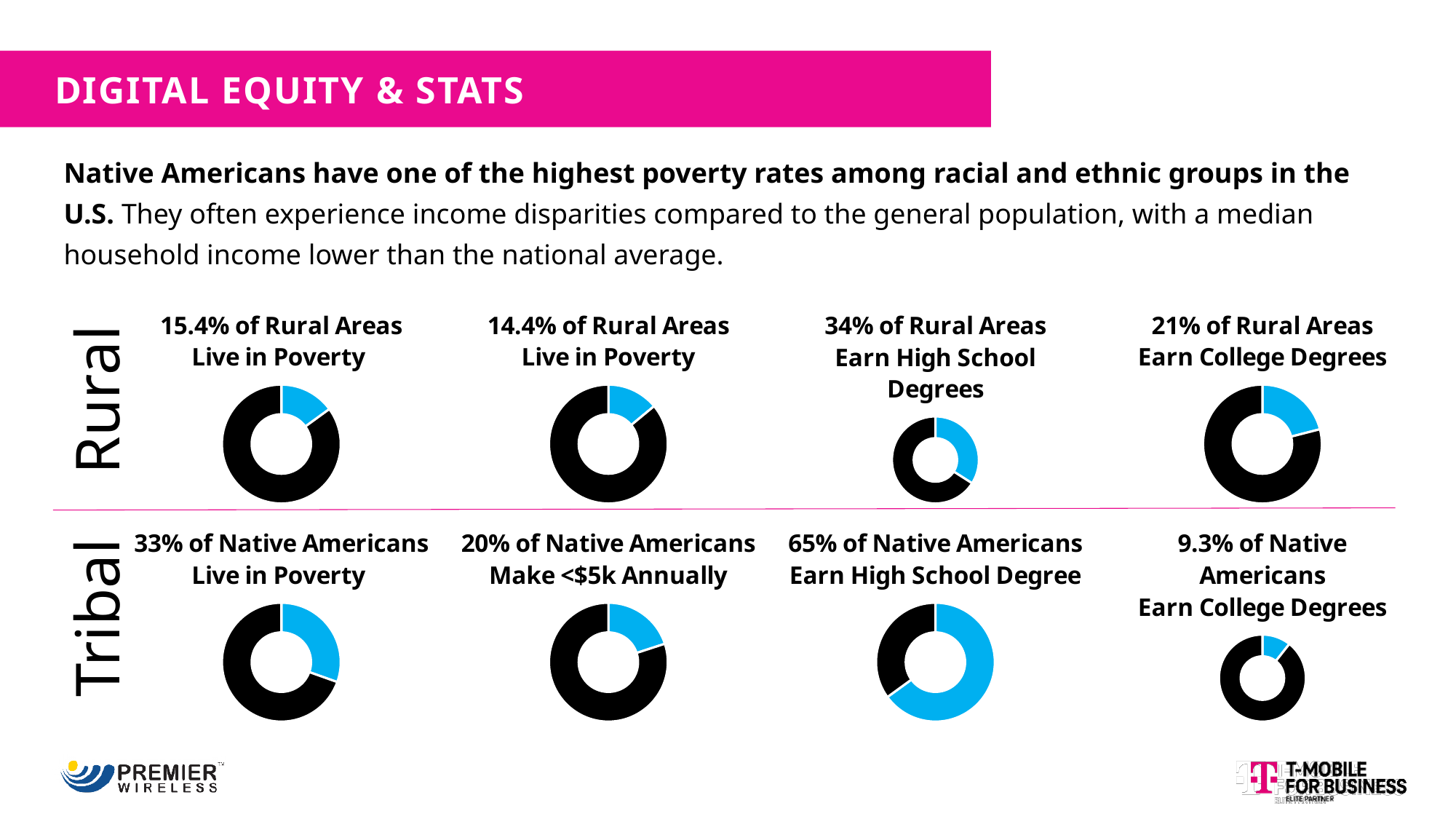
What colour is used for the highlighted slice in each donut chart? Blue Which is larger: the share of Native Americans living in poverty (Tribal row, first chart) or the share of rural areas living in poverty (Rural row, first chart)? Native Americans living in poverty (33%) Across all eight donut charts, which chart shows the smallest highlighted (blue) share? 9.3% of Native Americans Earn College Degrees In the Tribal row, what percentage of Native Americans make less than $5k annually according to the second chart? 20% What is the difference between the share of Native Americans earning a high school degree (Tribal row, third chart) and the share of rural areas earning high school degrees (Rural row, third chart)? 31% In the Rural row, what percentage of rural areas earn college degrees according to the fourth chart? 21% How many donut charts are on the slide? 8 What kind of charts are shown on the slide? Donut (pie) charts What is the difference between the share of rural areas earning college degrees (Rural row, fourth chart) and the share of Native Americans earning college degrees (Tribal row, fourth chart)? 11.7% In the Tribal row, what percentage of Native Americans earn college degrees according to the fourth chart? 9.3% Across all eight donut charts, which chart shows the largest highlighted (blue) share? 65% of Native Americans Earn High School Degree In the Rural row, what percentage of rural areas earn high school degrees according to the third chart? 34%